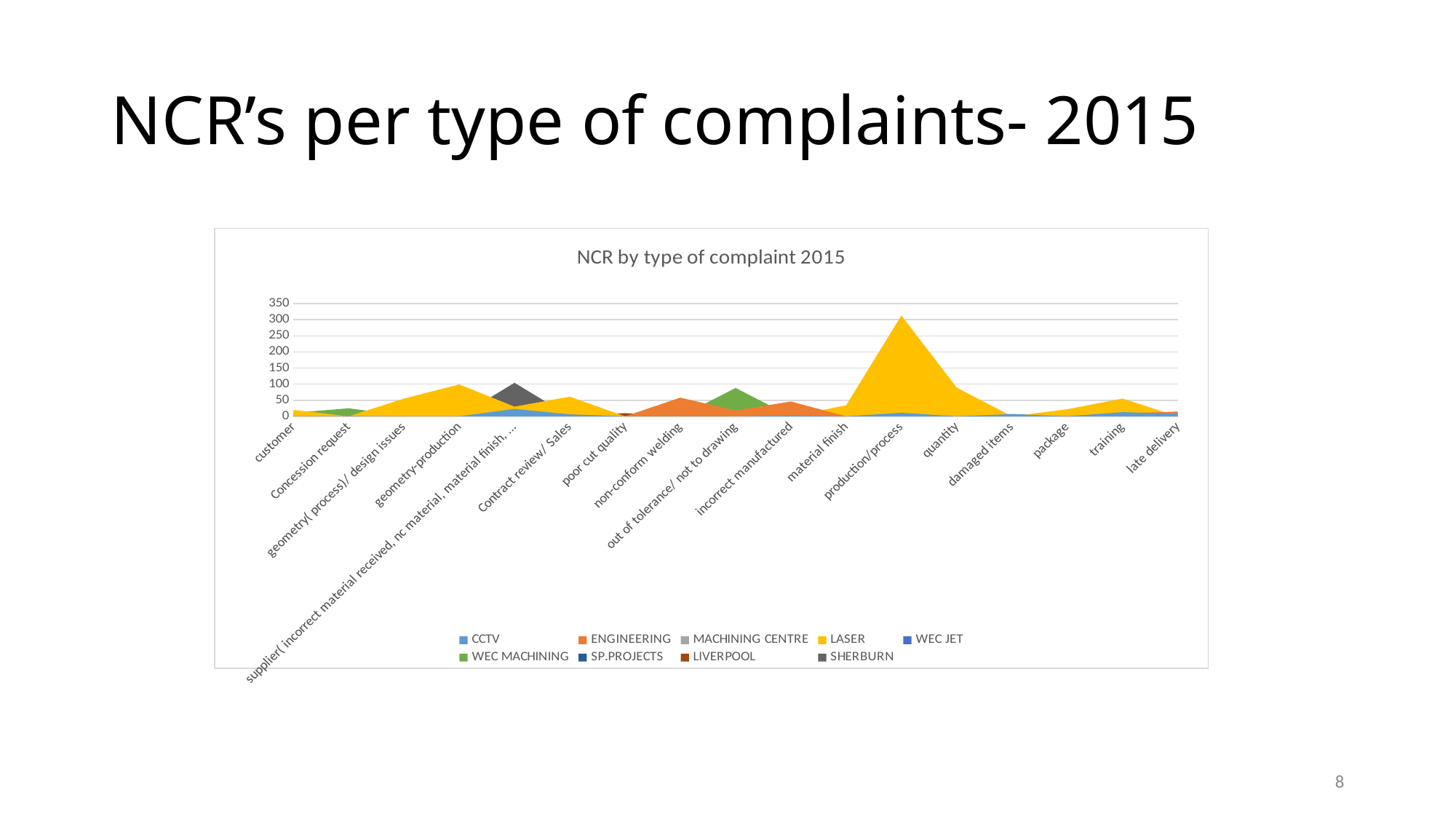
How many complaint categories are shown on the x axis? 17 Is the total value for production/process greater or less than 250? greater Which has a larger total value, production/process or quantity? production/process Which has a larger total value, geometry-production or poor cut quality? geometry-production Which series is shown in yellow in the legend? LASER What is the title of the chart? NCR by type of complaint 2015 Which complaint category has the highest total NCR value? production/process What type of chart is shown on the slide? Area chart How many series does the legend list? 9 Is the total value for damaged items greater or less than 50? less Is the total value for out of tolerance/ not to drawing greater or less than 150? less